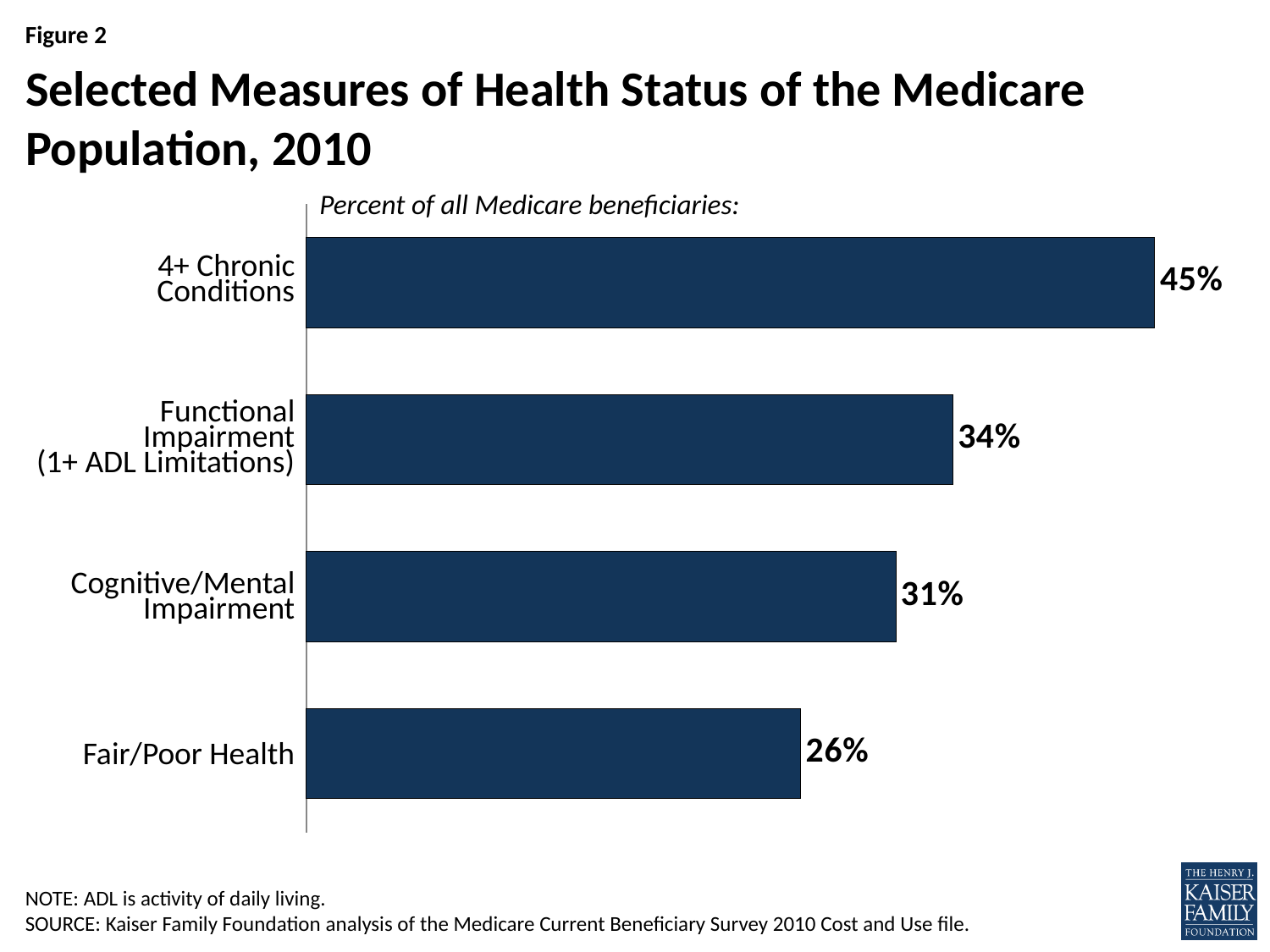
What percent of Medicare beneficiaries have 4+ Chronic Conditions? 45% Which measure has the highest percentage of Medicare beneficiaries? 4+ Chronic Conditions What kind of chart is shown on the slide? Bar chart What is the difference in percentage points between 4+ Chronic Conditions and Fair/Poor Health? 19 percentage points Which measure has the lowest percentage of Medicare beneficiaries? Fair/Poor Health What is the value shown for Fair/Poor Health? 26% Which is larger: the value for Cognitive/Mental Impairment or the value for Fair/Poor Health? Cognitive/Mental Impairment What is the difference between Functional Impairment (1+ ADL Limitations) and Cognitive/Mental Impairment? 3 percentage points How many health status measures are plotted on the chart? 4 What is the value shown for Functional Impairment (1+ ADL Limitations)? 34% What percent of Medicare beneficiaries have Cognitive/Mental Impairment? 31% What is the title of the chart on the slide? Selected Measures of Health Status of the Medicare Population, 2010